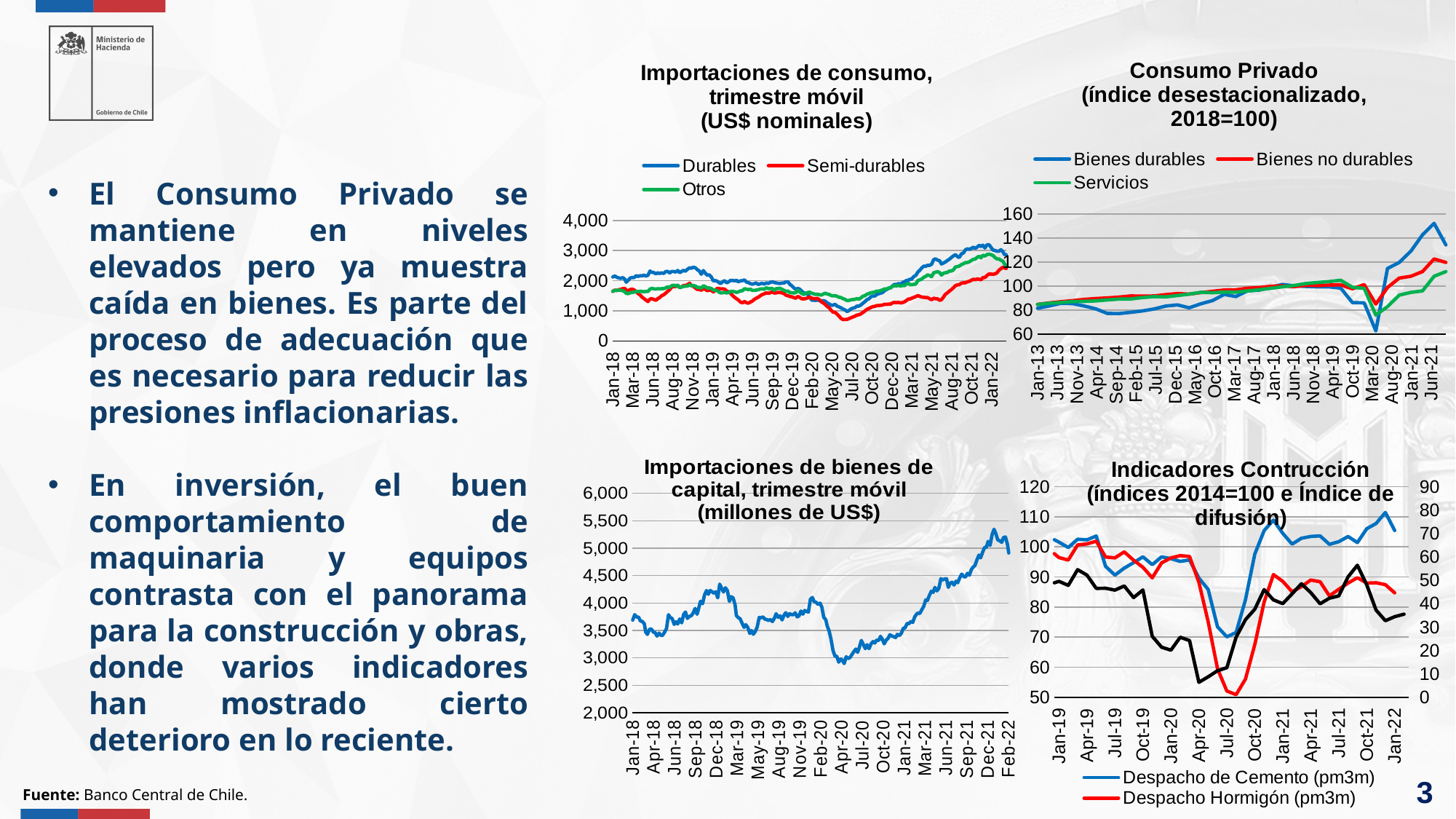
In 'Importaciones de consumo, trimestre móvil', which series is lowest at Jul-20? Semi-durables In 'Importaciones de bienes de capital, trimestre móvil (millones de US$)', do the values rise or fall from Apr-20 to Dec-21? rise How many series does the legend of 'Importaciones de consumo, trimestre móvil' list? 3 What kind of chart is 'Importaciones de consumo, trimestre móvil (US$ nominales)'? line chart In 'Consumo Privado (índice desestacionalizado, 2018=100)', is the value for Bienes durables at Mar-20 greater or less than 80? less In 'Importaciones de consumo, trimestre móvil', is the value for Semi-durables at Jul-20 greater or less than 1,000? less In 'Indicadores Contrucción', is the value for Despacho Hormigón (pm3m) at Jul-20 greater or less than 60? less According to the slide, what is the source of the charts? Banco Central de Chile In 'Consumo Privado (índice desestacionalizado, 2018=100)', which series is highest at Jun-21? Bienes durables How many series does the legend of 'Consumo Privado (índice desestacionalizado, 2018=100)' list? 3